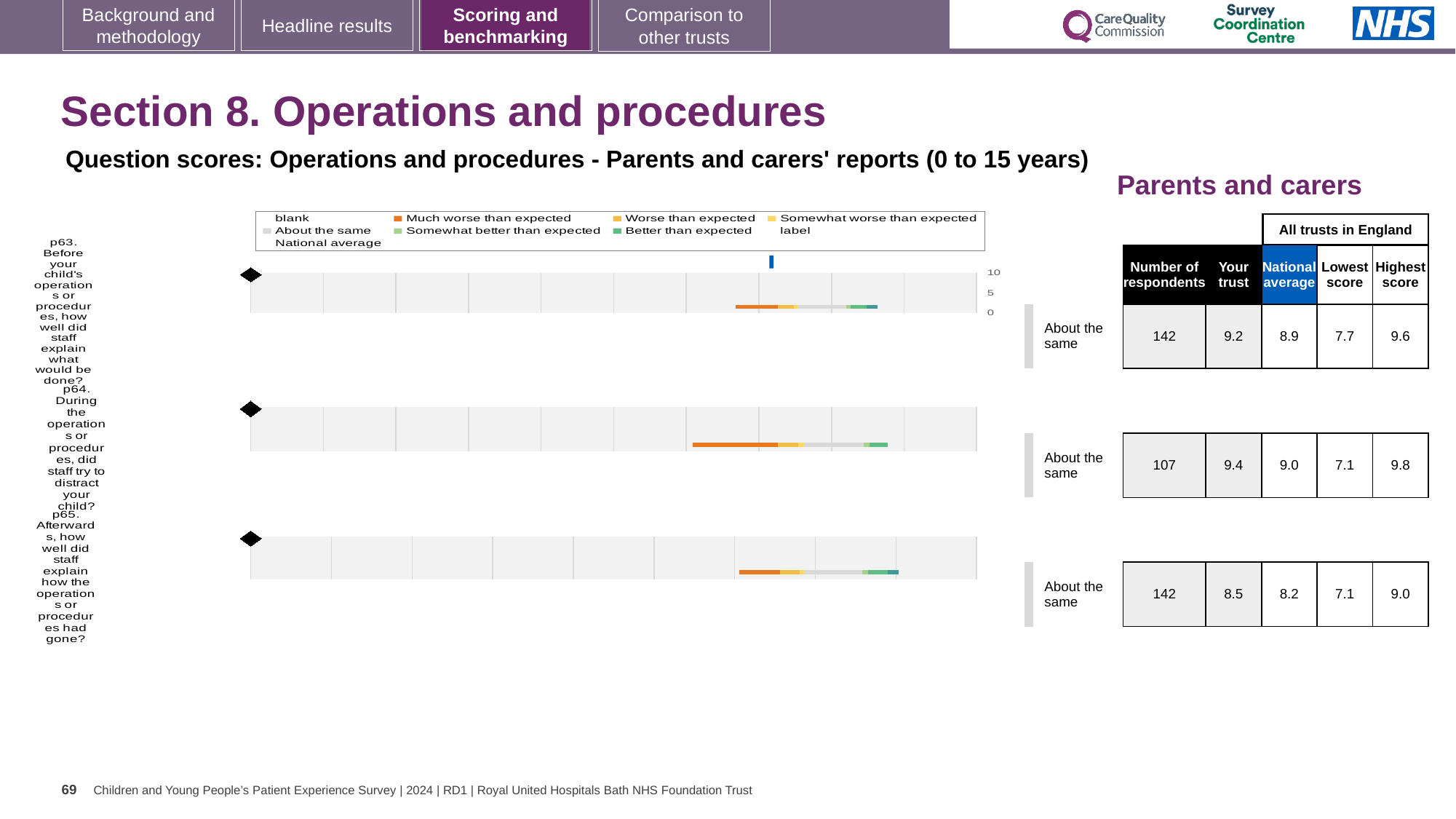
What benchmark category is shown for all three questions on this slide? About the same What is the highest score among all trusts in England for p65 (how well staff explained how the operation had gone)? 9.0 What is the 'Your trust' score for p63 (how well staff explained what would be done before the operation)? 9.2 Which question has the lowest 'Your trust' score? p65 What is the national average score for p64 (did staff try to distract your child during the operation)? 9.0 For p65, which is larger: the 'Your trust' score or the national average? Your trust How many respondents answered p64? 107 What is the lowest score among all trusts in England for p63? 7.7 How many questions (p63, p64, p65) have a score bar plotted on the slide? 3 What kind of chart is used to show the question scores on this slide? bar chart Which question has the highest 'Your trust' score? p64 For p63, how much higher is the 'Your trust' score than the national average? 0.3